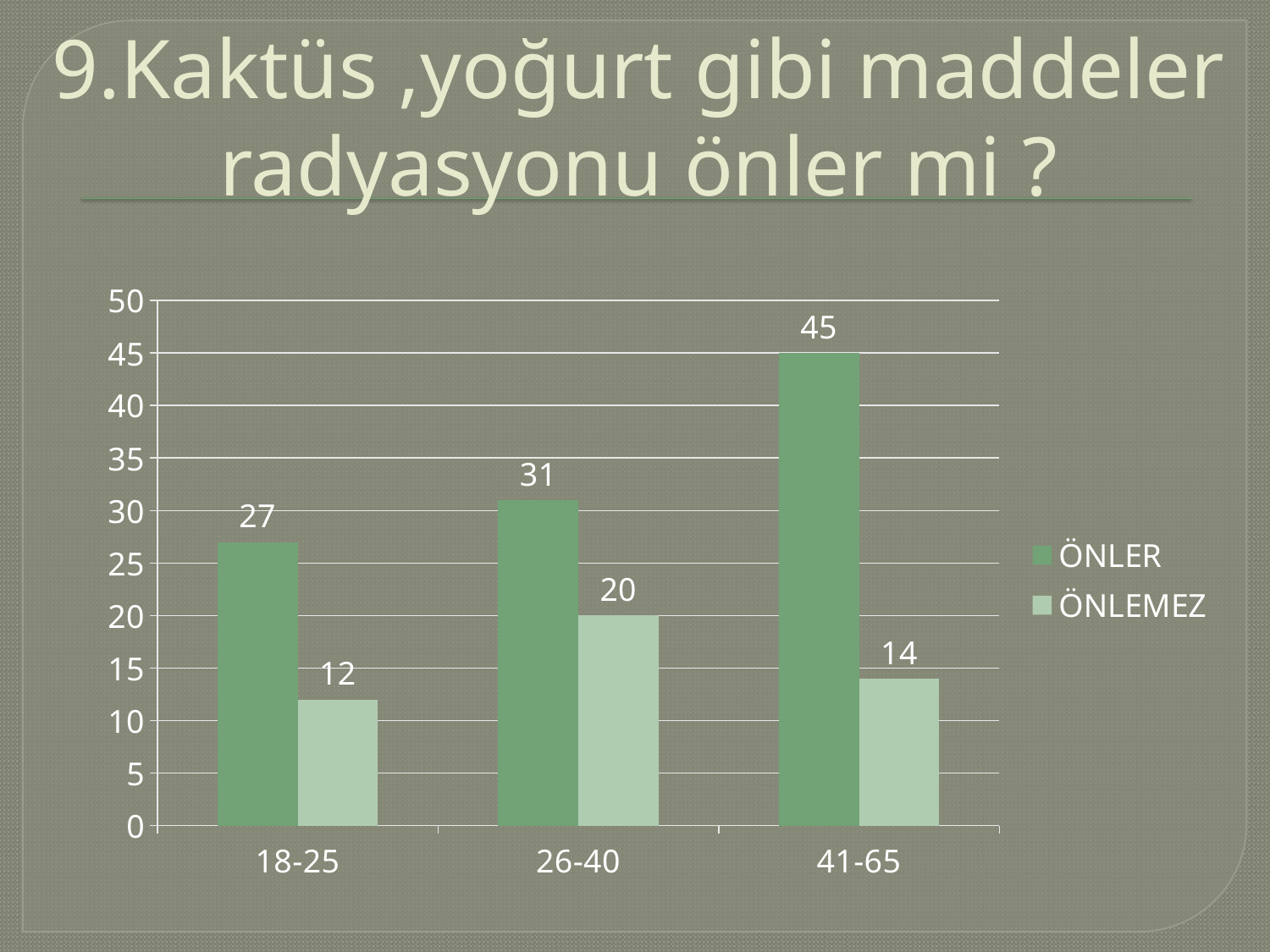
Which age group has the highest ÖNLER value? 41-65 How many series does the legend list? 2 Which age group has the lowest ÖNLEMEZ value? 18-25 Do the ÖNLER values rise or fall from the 18-25 group to the 41-65 group? rise How many age groups are shown on the x axis? 3 What is the difference between the ÖNLER and ÖNLEMEZ values for the 41-65 age group? 31 What is the ÖNLEMEZ value for the 26-40 age group? 20 What is the ÖNLER value for the 41-65 age group? 45 What kind of chart is shown on the slide? bar chart Is the ÖNLER value for the 26-40 age group greater or less than 30? greater Which is larger for the 26-40 age group, ÖNLER or ÖNLEMEZ? ÖNLER What is the ÖNLER value for the 18-25 age group? 27